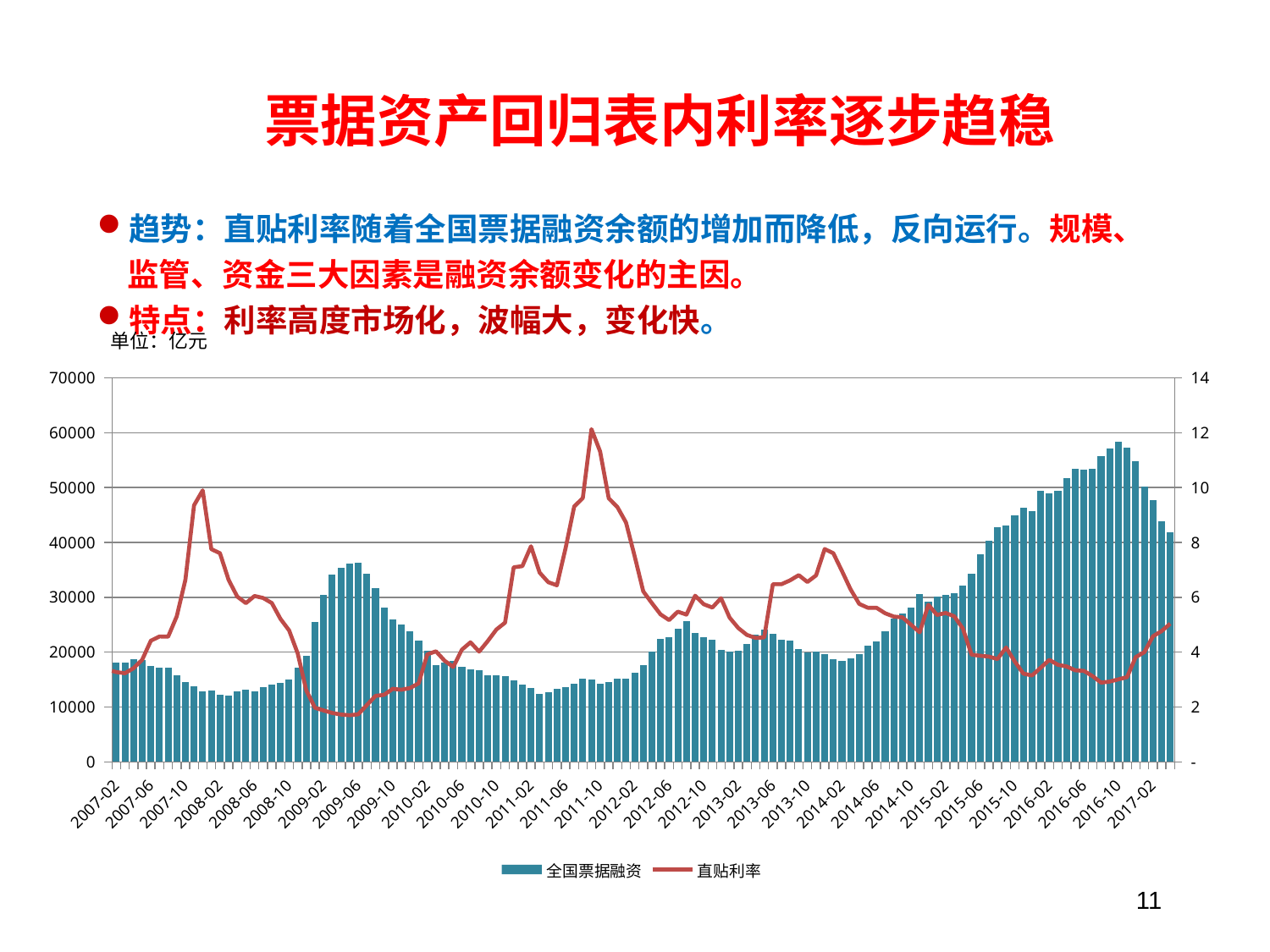
Around which x-axis label does 直贴利率 reach its highest value? 2011-10 Is the value of 全国票据融资 at 2007-02 greater or less than 20000? less How many series does the chart legend list? 2 Does 全国票据融资 rise or fall between 2014-06 and 2016-10? rise Is the value of 直贴利率 at 2011-10 greater or less than 10? greater Is the value of 全国票据融资 at 2016-10 greater or less than 50000? greater What kind of chart is shown on the slide? Combined bar and line chart Which is larger, the value of 全国票据融资 at 2016-10 or at 2009-06? 2016-10 Around which x-axis label does 全国票据融资 reach its highest value? 2016-10 What are the two series named in the chart legend? 全国票据融资 and 直贴利率